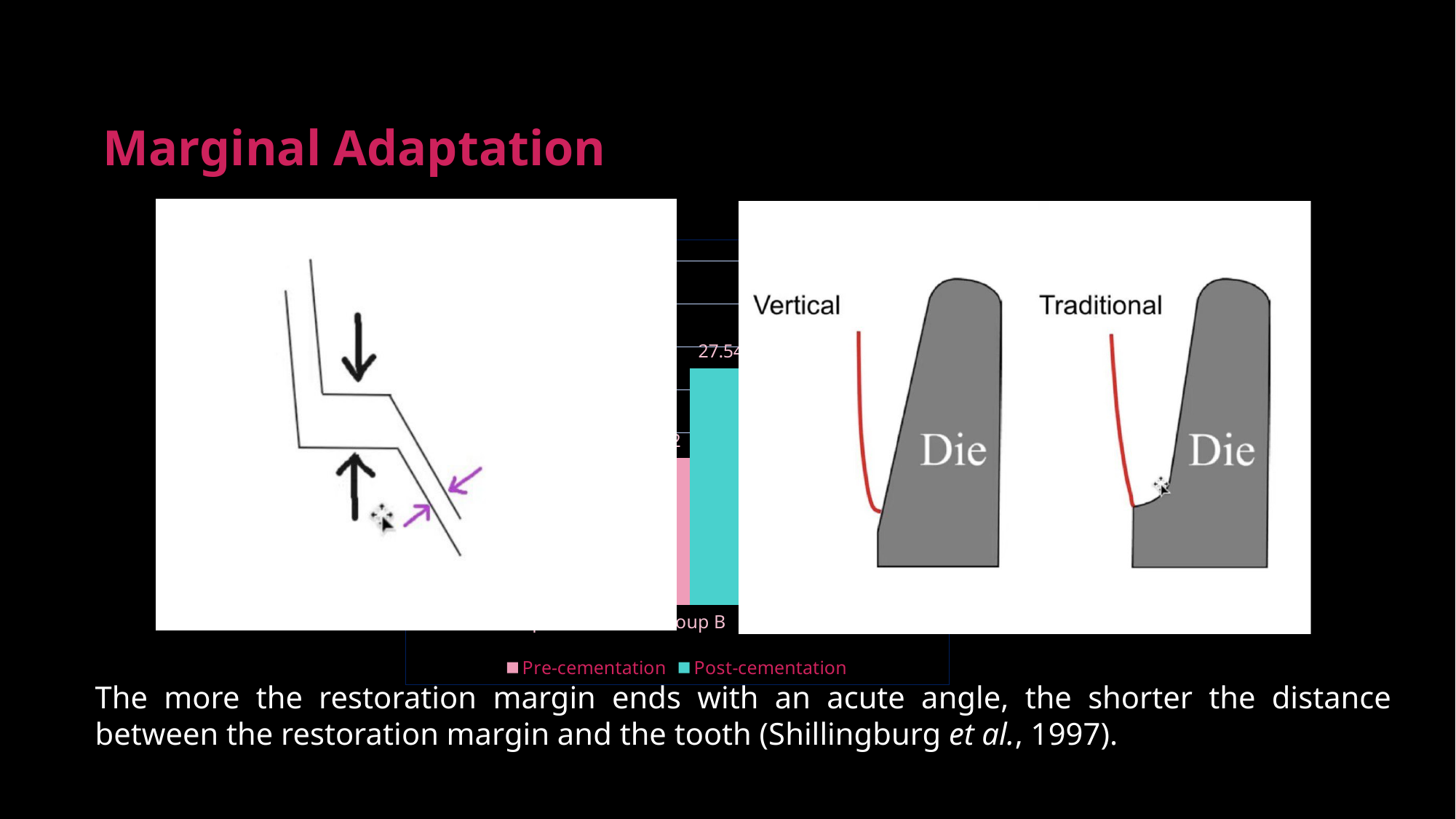
How many series does the chart legend list? 2 What kind of chart is partially visible on the slide? bar chart What are the two series named in the chart legend? Pre-cementation and Post-cementation In the visible category of the chart, which series has the taller bar, Pre-cementation or Post-cementation? Post-cementation Which colour represents the Post-cementation series in the chart? teal